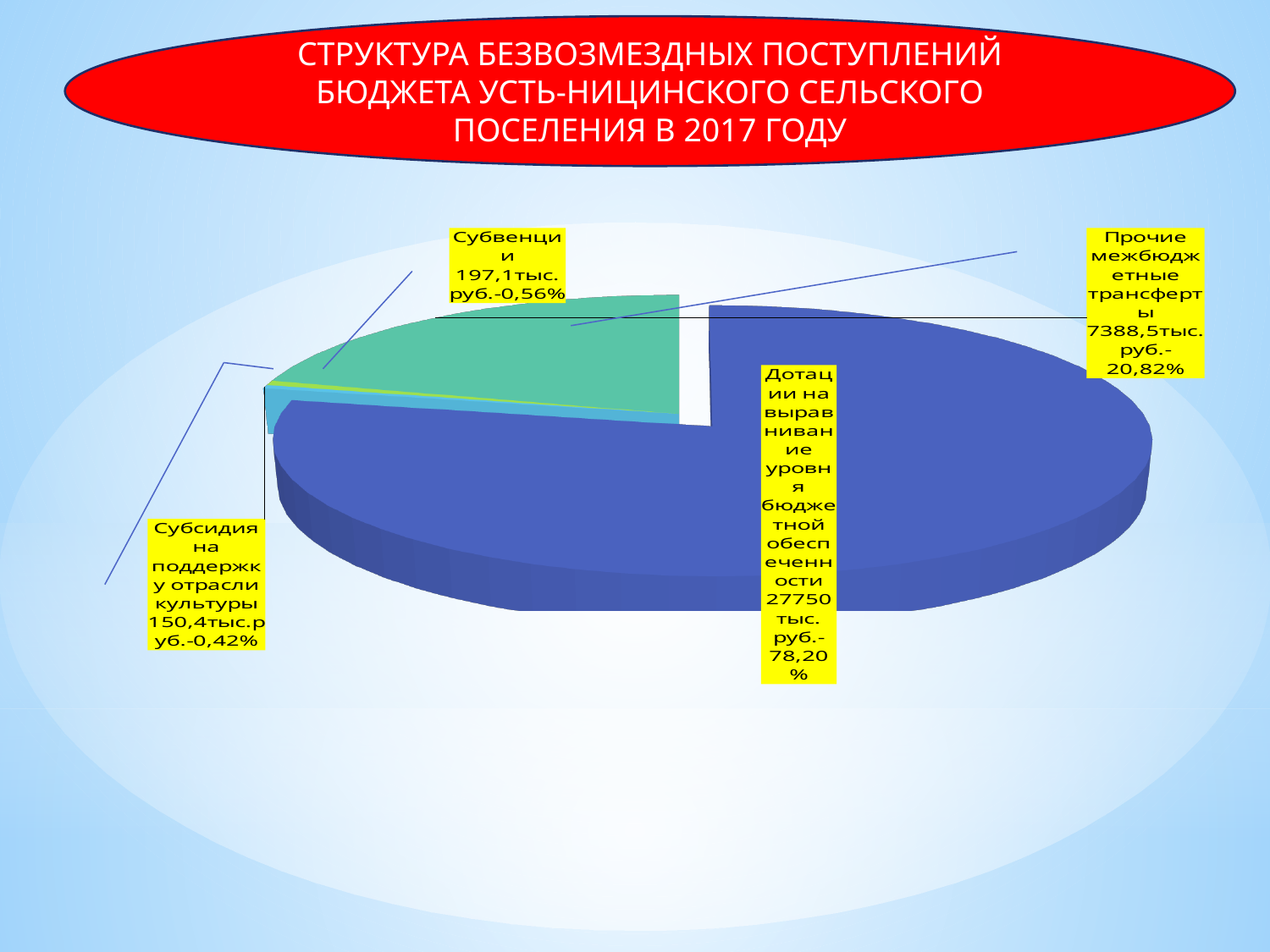
How many slices does the pie chart have? 4 Which category has the smallest share of the pie? Субсидия на поддержку отрасли культуры What year does the chart title refer to? 2017 What is the difference in percentage share between Дотации на выравнивание уровня бюджетной обеспеченности and Прочие межбюджетные трансферты? 57,38% Which is larger: Субвенции or Субсидия на поддержку отрасли культуры? Субвенции Which category has the largest share of the pie? Дотации на выравнивание уровня бюджетной обеспеченности What is the value shown for Субвенции? 197,1 тыс. руб. What share of the pie is Прочие межбюджетные трансферты? 20,82% What share of the pie is Субсидия на поддержку отрасли культуры? 0,42% What is the value shown for Прочие межбюджетные трансферты? 7388,5 тыс. руб. What is the value shown for Дотации на выравнивание уровня бюджетной обеспеченности? 27750 тыс. руб. What kind of chart is shown on the slide? Pie chart